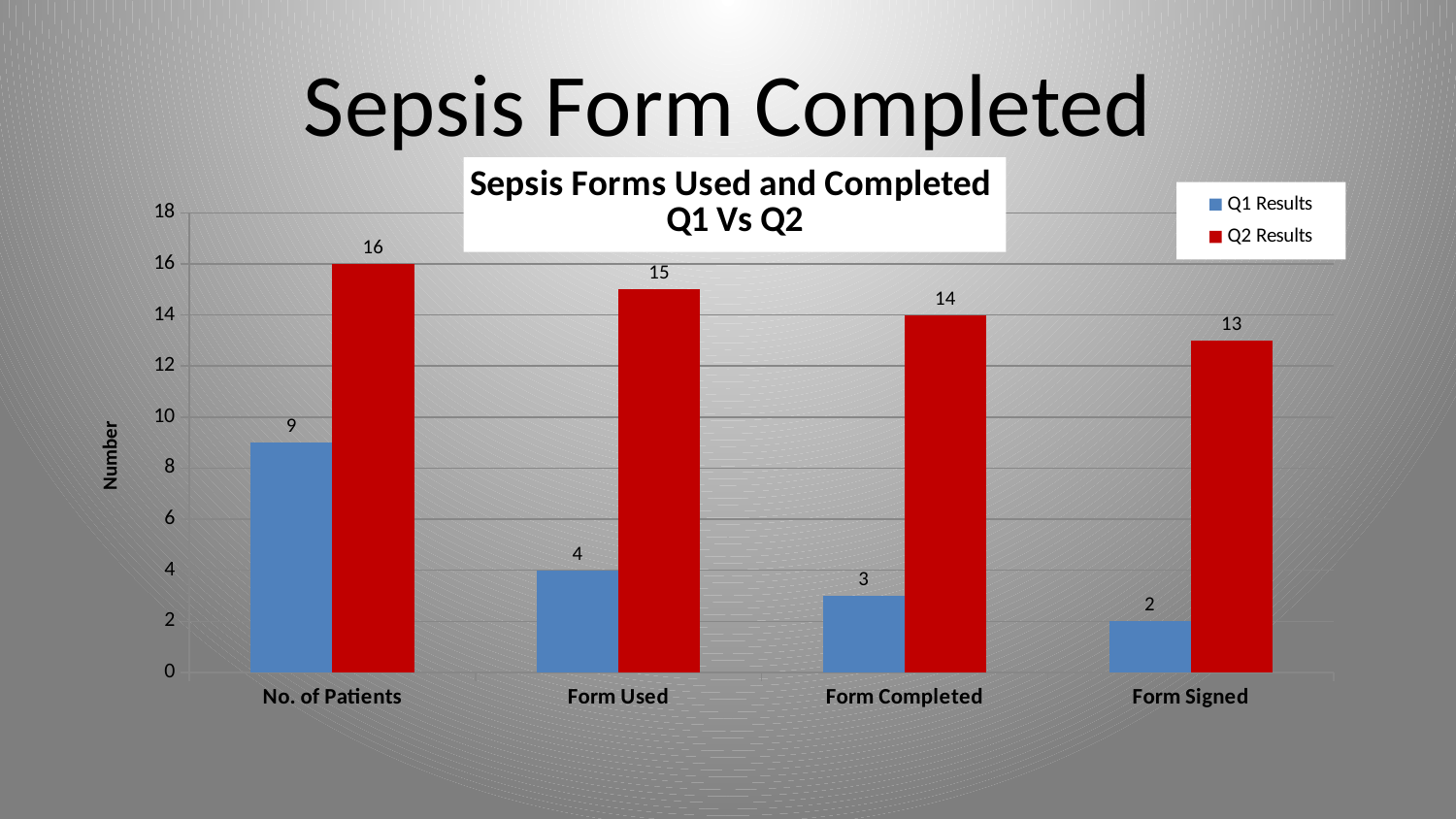
What is the Q1 Results value for Form Completed? 3 What kind of chart is shown on the slide? Bar chart What is the Q1 Results value for No. of Patients? 9 How many series does the legend list? 2 What is the title of the chart? Sepsis Forms Used and Completed Q1 Vs Q2 Is the Q2 Results value for Form Completed greater or less than 10? greater Which category has the lowest Q1 Results value? Form Signed Which category has the highest Q2 Results value? No. of Patients What is the Q2 Results value for Form Signed? 13 How many categories are shown on the x axis? 4 What is the difference between the Q2 Results and Q1 Results values for Form Used? 11 Which is larger: the Q1 Results value for No. of Patients or the Q2 Results value for Form Signed? Q2 Results value for Form Signed